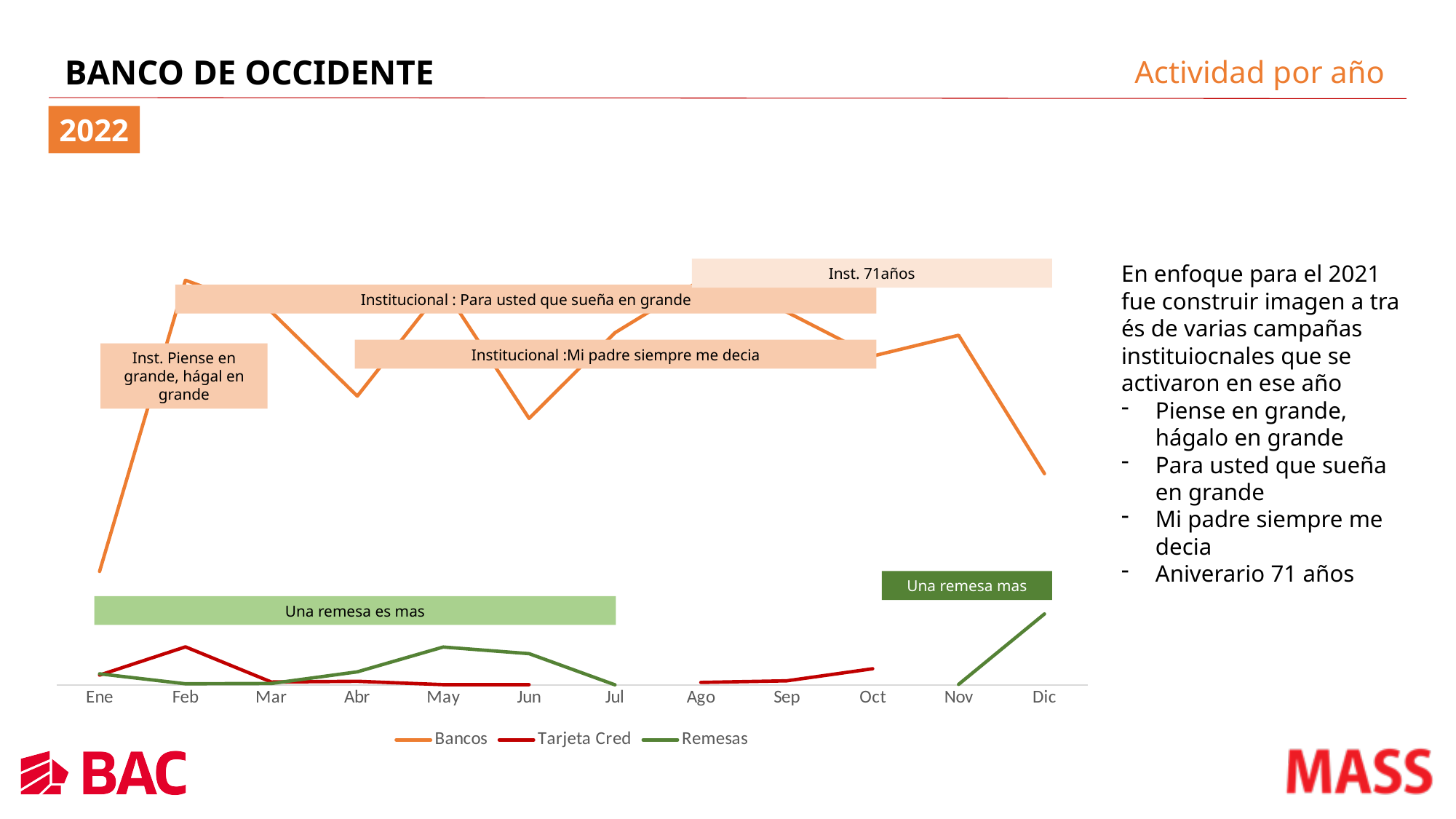
How many series does the chart legend list? 3 In which month does the Tarjeta Cred series reach its highest value? Feb Does the Bancos series rise or fall from Nov to Dic? Fall How many months are shown along the x axis of the chart? 12 In which month does the Bancos series have its lowest value? Ene Which series has the higher value in Feb, Bancos or Remesas? Bancos In which month does the Remesas series reach its highest value? Dic Which series has the higher value in May, Remesas or Tarjeta Cred? Remesas What colour is the Remesas series in the chart? Green What kind of chart is shown on the slide? Line chart Does the Remesas series rise or fall from Nov to Dic? Rise